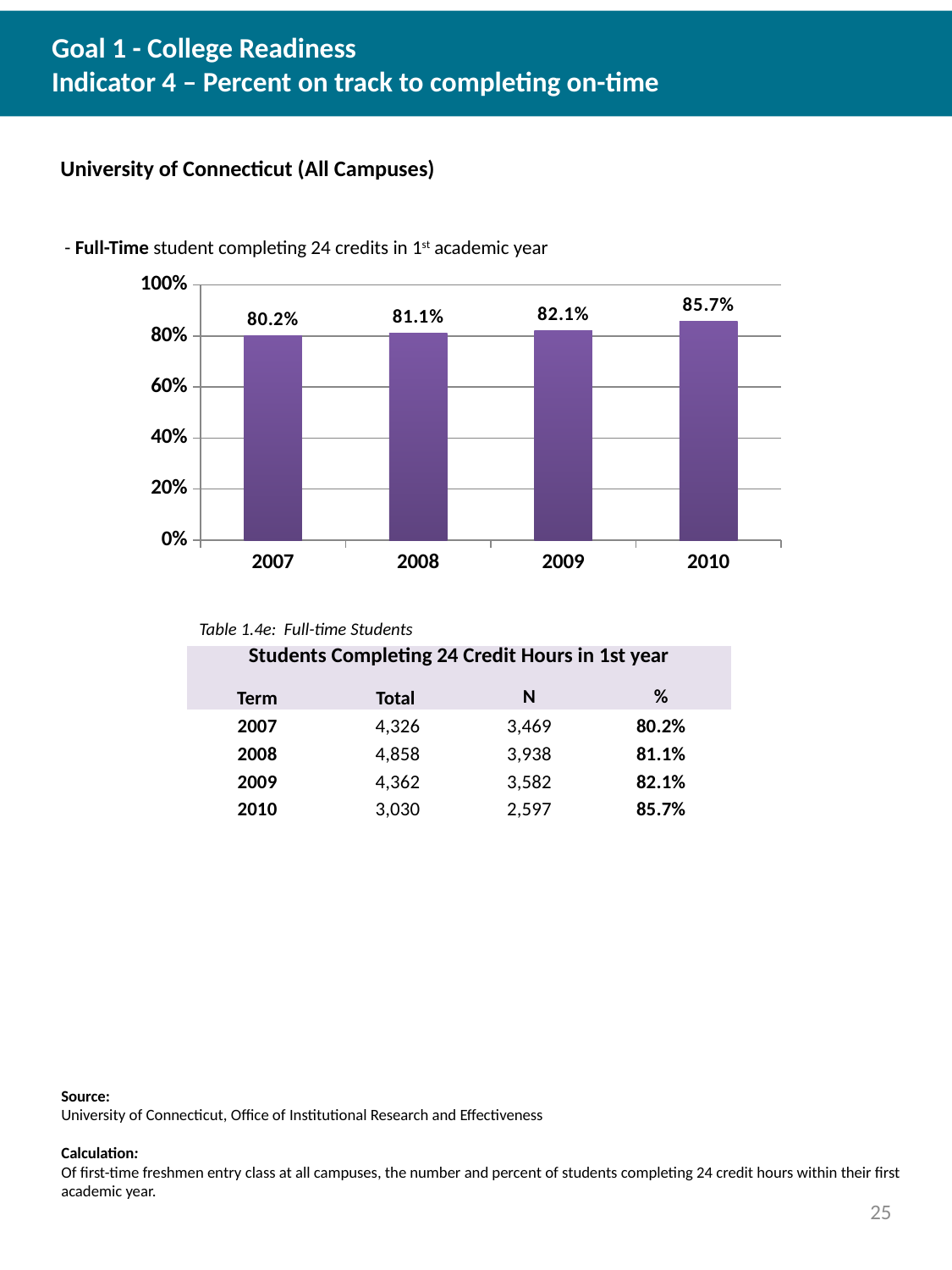
Is the value for 2010 greater or less than 80%? greater How many years are shown on the x axis? 4 What is the value for 2009? 82.1% What is the difference between the values for 2010 and 2007? 5.5% What is the value for 2007? 80.2% What kind of chart is shown? bar chart Which year has the highest value? 2010 What is the value for 2010? 85.7% Which is larger, the value for 2009 or the value for 2008? 2009 Which year has the lowest value? 2007 Do the values rise or fall from 2007 to 2010? rise What is the value for 2008? 81.1%